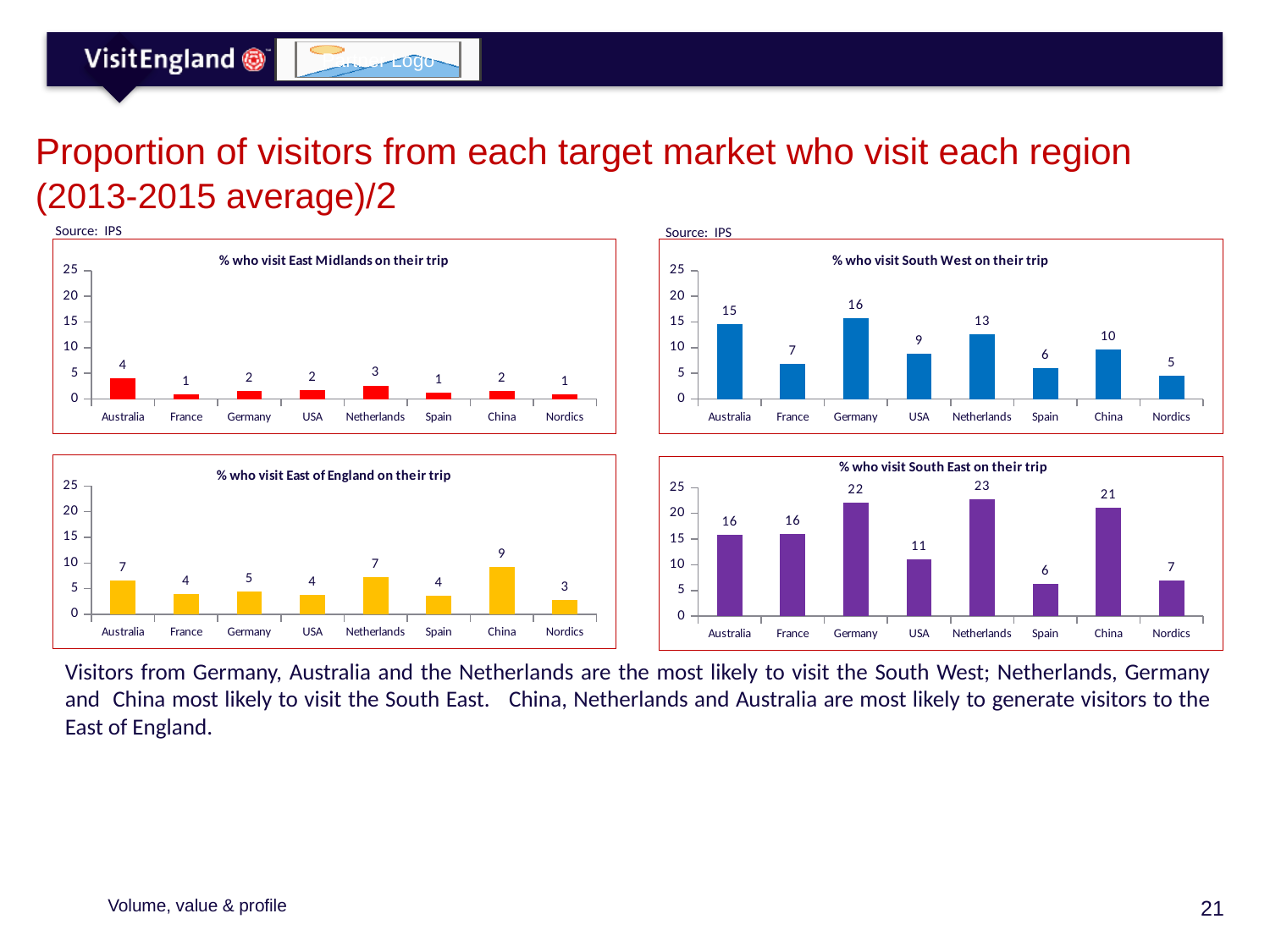
In the '% who visit South West on their trip' chart, what is the value for Germany? 16 What kind of chart is the '% who visit East Midlands on their trip' chart? Bar chart In the '% who visit South East on their trip' chart, is the value for China greater or less than 20? greater In the '% who visit South West on their trip' chart, which market has the lowest value? Nordics In the '% who visit South East on their trip' chart, what is the difference between the values for Germany and Spain? 16 In the '% who visit South West on their trip' chart, which is larger, the value for Netherlands or the value for China? Netherlands How many markets are shown on the x axis of the '% who visit East of England on their trip' chart? 8 In the '% who visit South East on their trip' chart, which market has the highest value? Netherlands What colour are the bars in the '% who visit South East on their trip' chart? Purple In the '% who visit East of England on their trip' chart, what is the value for China? 9 In the '% who visit East Midlands on their trip' chart, which market has the highest value? Australia In the '% who visit South East on their trip' chart, what is the value for the USA? 11